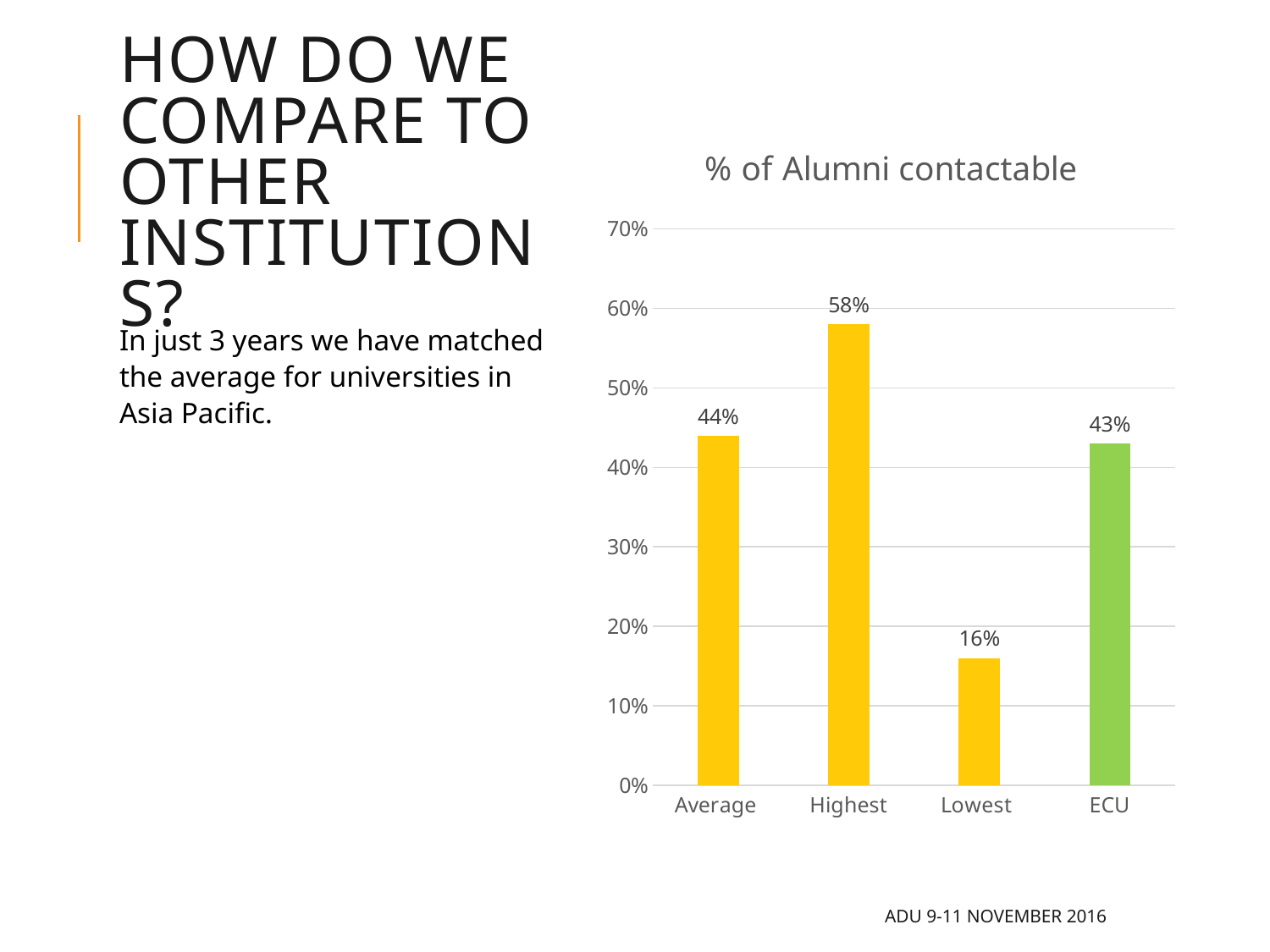
What is the value for Highest in the chart? 58% Which is larger, the value for Highest or the value for ECU? Highest How many categories are shown in the chart? 4 What is the value for Average in the chart? 44% What is the difference between the Average and ECU values? 1% What is the difference between the Highest and Lowest values? 42% Which category has the lowest value in the chart? Lowest What is the title of the chart? % of Alumni contactable What kind of chart is shown on the slide? Bar chart Which category has the highest value in the chart? Highest What is the value for Lowest in the chart? 16% What is the value for ECU in the chart? 43%